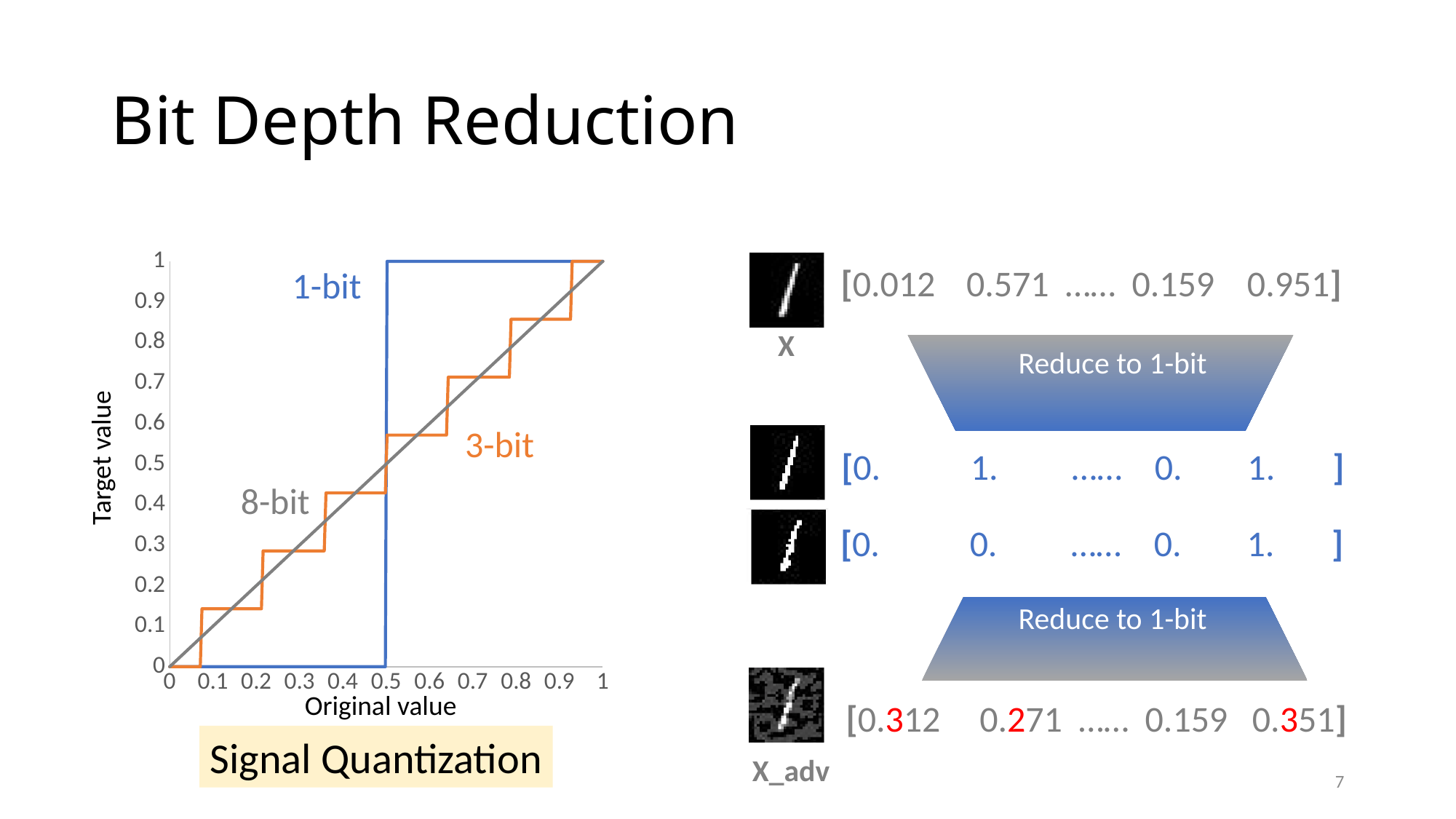
At what original value does the 1-bit curve jump from 0 to 1? 0.5 What kind of chart is shown on the slide? line chart How many curves are labelled on the chart? 3 Is the target value of the 3-bit curve at an original value of 0.3 greater or less than 0.5? less Is the target value of the 3-bit curve at an original value of 0.7 greater or less than 0.5? greater What is the target value of the 8-bit curve at an original value of 0.5? 0.5 What is the target value of the 1-bit curve at an original value of 0.3? 0 At an original value of 0.9, which curve has the higher target value, 1-bit or 3-bit? 1-bit Does the target value of the 8-bit curve rise or fall as the original value increases? rise What is the target value of the 1-bit curve at an original value of 0.8? 1 What colour is the 3-bit curve on the chart? orange What is the label on the x axis of the chart? Original value